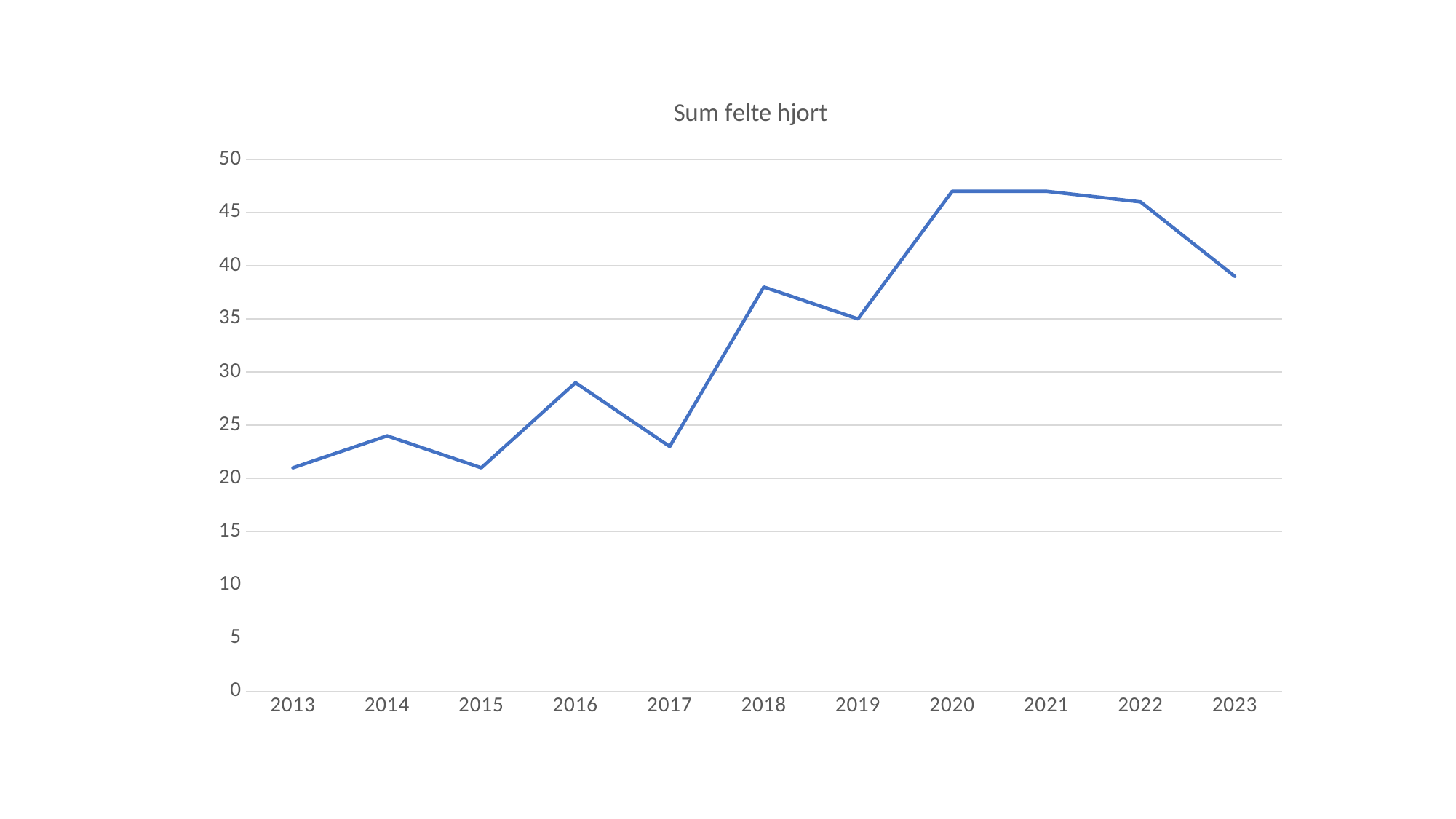
What is the title of the chart? Sum felte hjort Is the value for 2013 greater or less than 20? greater Is the value for 2017 greater or less than 25? less How many years are plotted on the x axis? 11 Does the value rise or fall from 2013 to 2020 overall? rise Is the value for 2016 greater or less than 30? less What kind of chart is shown on the slide? line chart Which year has the larger value, 2022 or 2023? 2022 Which year has the larger value, 2016 or 2017? 2016